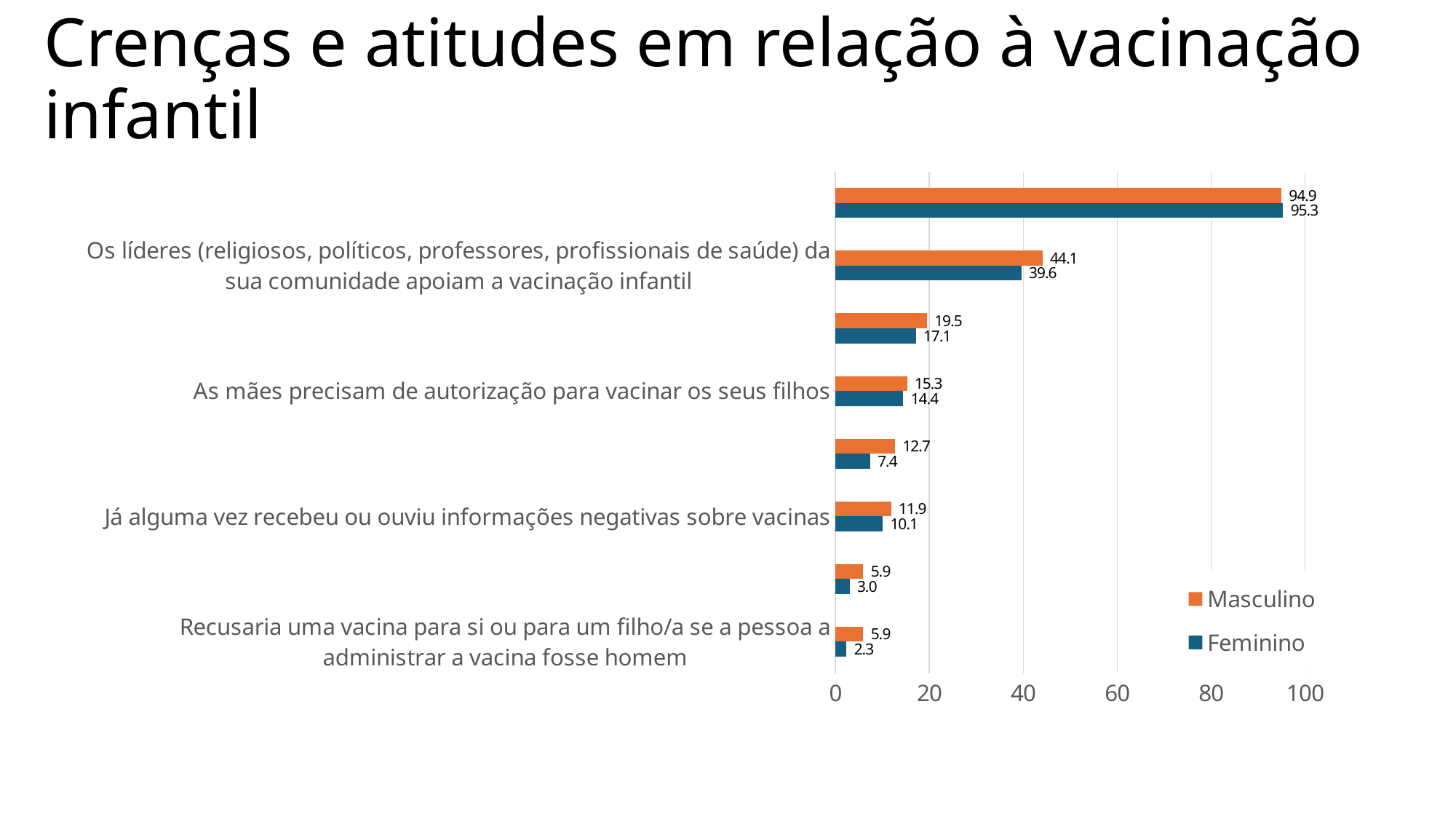
What is the Masculino value for 'As mães precisam de autorização para vacinar os seus filhos'? 15.3 What is the Feminino value for 'Já alguma vez recebeu ou ouviu informações negativas sobre vacinas'? 10.1 How many series does the legend list? 2 What is the Feminino value for 'Recusaria uma vacina para si ou para um filho/a se a pessoa a administrar a vacina fosse homem'? 2.3 How many category groups of bars are plotted on the chart? 8 What kind of chart is shown on the slide? Bar chart What is the difference between the Masculino and Feminino values for 'Recusaria uma vacina para si ou para um filho/a se a pessoa a administrar a vacina fosse homem'? 3.6 What is the Masculino value for 'Os líderes (religiosos, políticos, professores, profissionais de saúde) da sua comunidade apoiam a vacinação infantil'? 44.1 What is the difference between the Masculino and Feminino values for 'Os líderes (religiosos, políticos, professores, profissionais de saúde) da sua comunidade apoiam a vacinação infantil'? 4.5 What is the largest value labelled on the chart? 95.3 For 'As mães precisam de autorização para vacinar os seus filhos', which series has the larger value, Masculino or Feminino? Masculino What is the Feminino value for 'Os líderes (religiosos, políticos, professores, profissionais de saúde) da sua comunidade apoiam a vacinação infantil'? 39.6